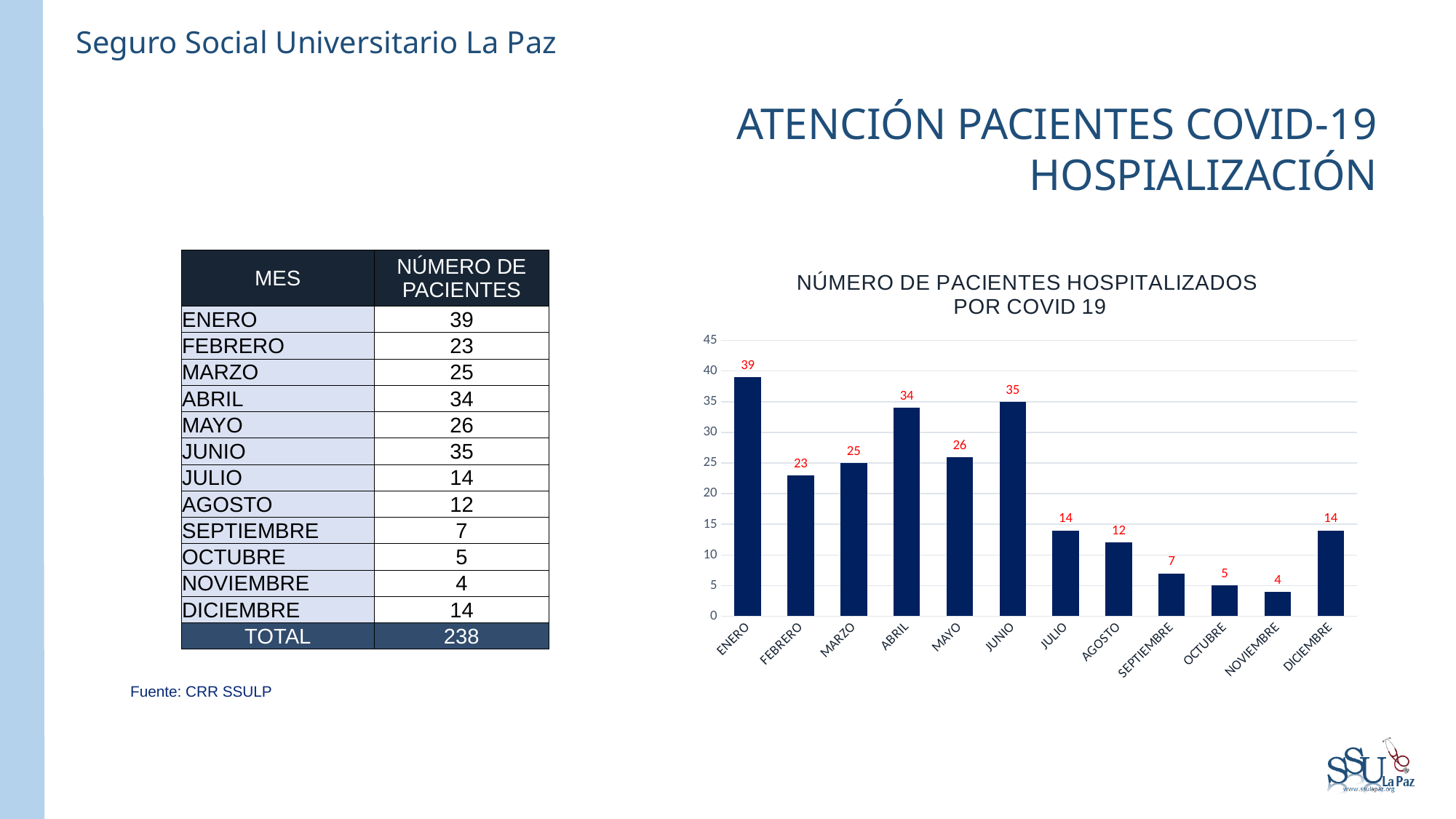
Do the values generally rise or fall from JUNIO to NOVIEMBRE? fall How many months are shown on the x axis of the chart? 12 Which month has the highest number of hospitalized patients in the chart? ENERO What is the title of the chart? NÚMERO DE PACIENTES HOSPITALIZADOS POR COVID 19 What is the value for SEPTIEMBRE in the chart? 7 Is the value for FEBRERO greater or less than 25? less What is the difference between the values for JUNIO and JULIO? 21 Which is larger, the value for MARZO or the value for MAYO? MAYO What is the highest value shown on the chart's vertical axis? 45 Which month has the lowest number of hospitalized patients in the chart? NOVIEMBRE What is the value for ABRIL in the chart? 34 What kind of chart is shown on the slide? bar chart